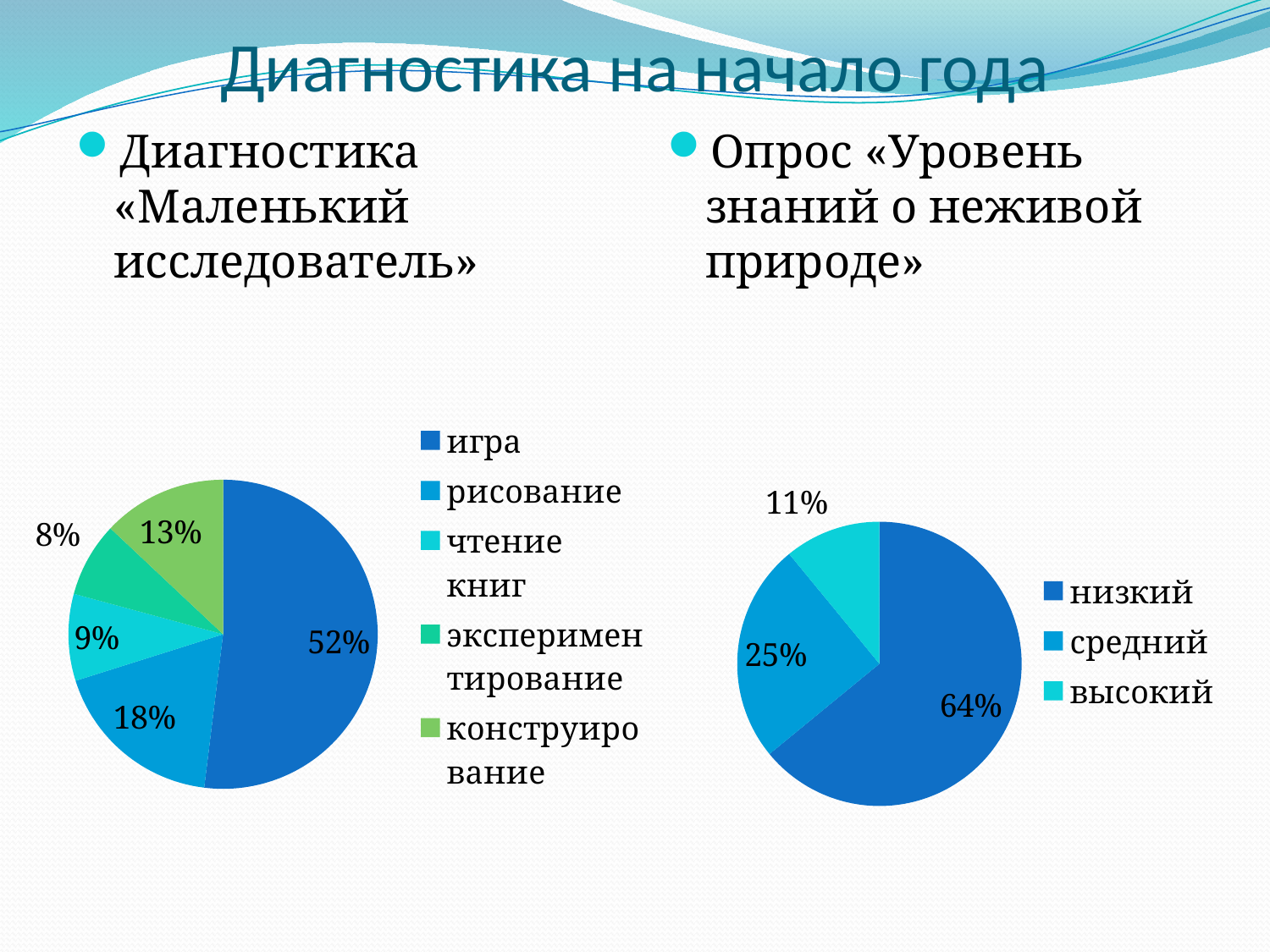
In the right pie chart, what is the value for средний? 25% What type of chart is the right chart? pie chart In the left pie chart, what is the value for игра? 52% In the left pie chart, what is the difference between the values for рисование and чтение книг? 9% In the right pie chart, what is the difference between the values for низкий and средний? 39% In the right pie chart, what is the value for высокий? 11% In the left pie chart, how many categories are shown? 5 In the left pie chart, which category has the largest slice? игра In the left pie chart, what is the value for рисование? 18% In the left pie chart, what is the value for конструирование? 13% In the left pie chart, which category has the smallest slice? экспериментирование In the right pie chart, which category has the largest slice? низкий